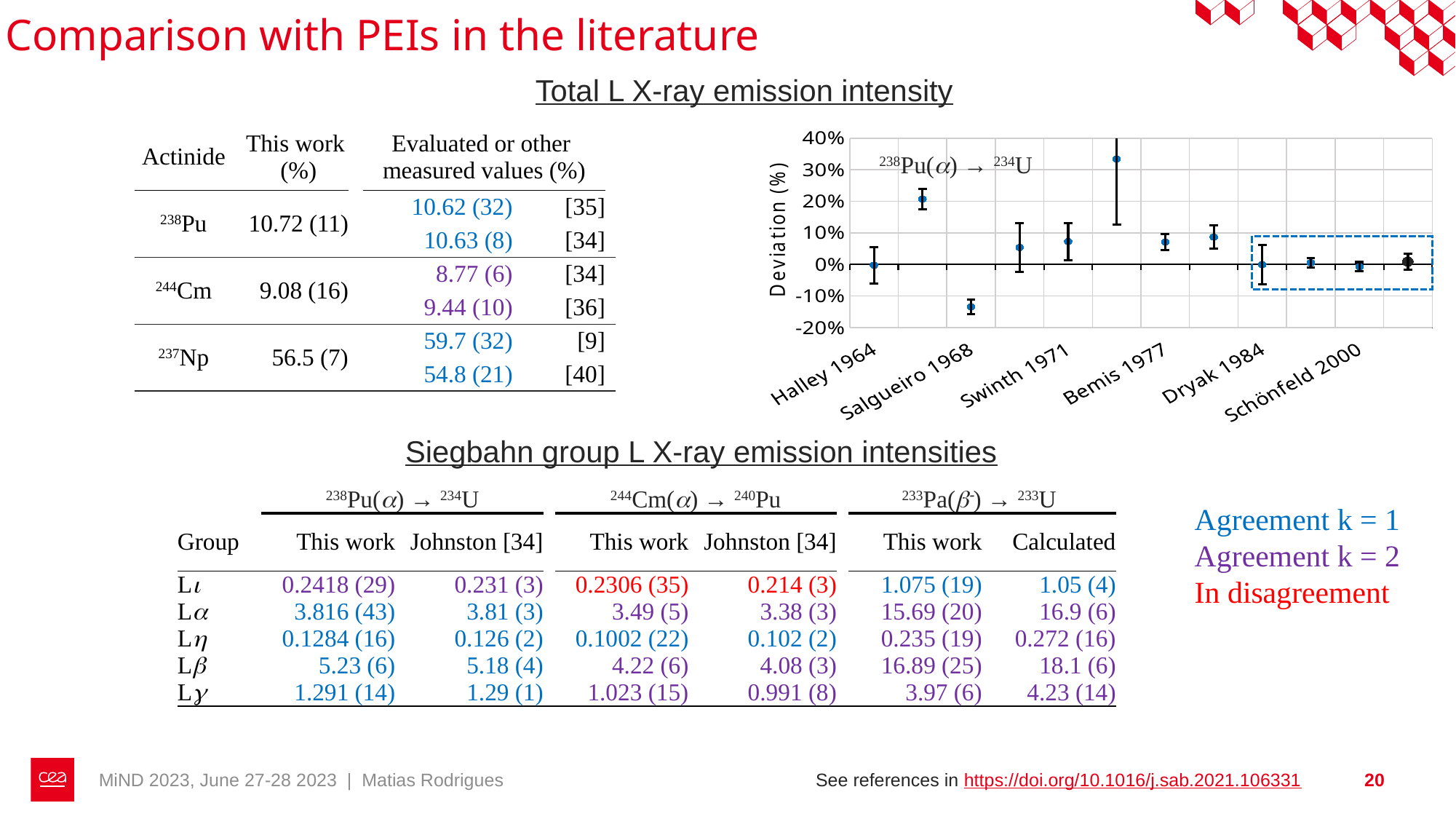
Which has the larger deviation, Halley 1964 or Swinth 1971? Swinth 1971 What is the title above the chart? Total L X-ray emission intensity Is the deviation for Swinth 1971 greater or less than 0%? greater Is the deviation for Halley 1964 greater or less than 10%? less What kind of chart is shown on the slide? Scatter chart with error bars Is the deviation for Bemis 1977 greater or less than 0%? greater What is the highest value shown on the y axis of the chart? 40% What is the label of the y axis of the chart? Deviation (%) Which labelled reference has the lowest deviation in the chart? Salgueiro 1968 How many data points are plotted in the chart? 12 Which has the larger deviation, Swinth 1971 or Salgueiro 1968? Swinth 1971